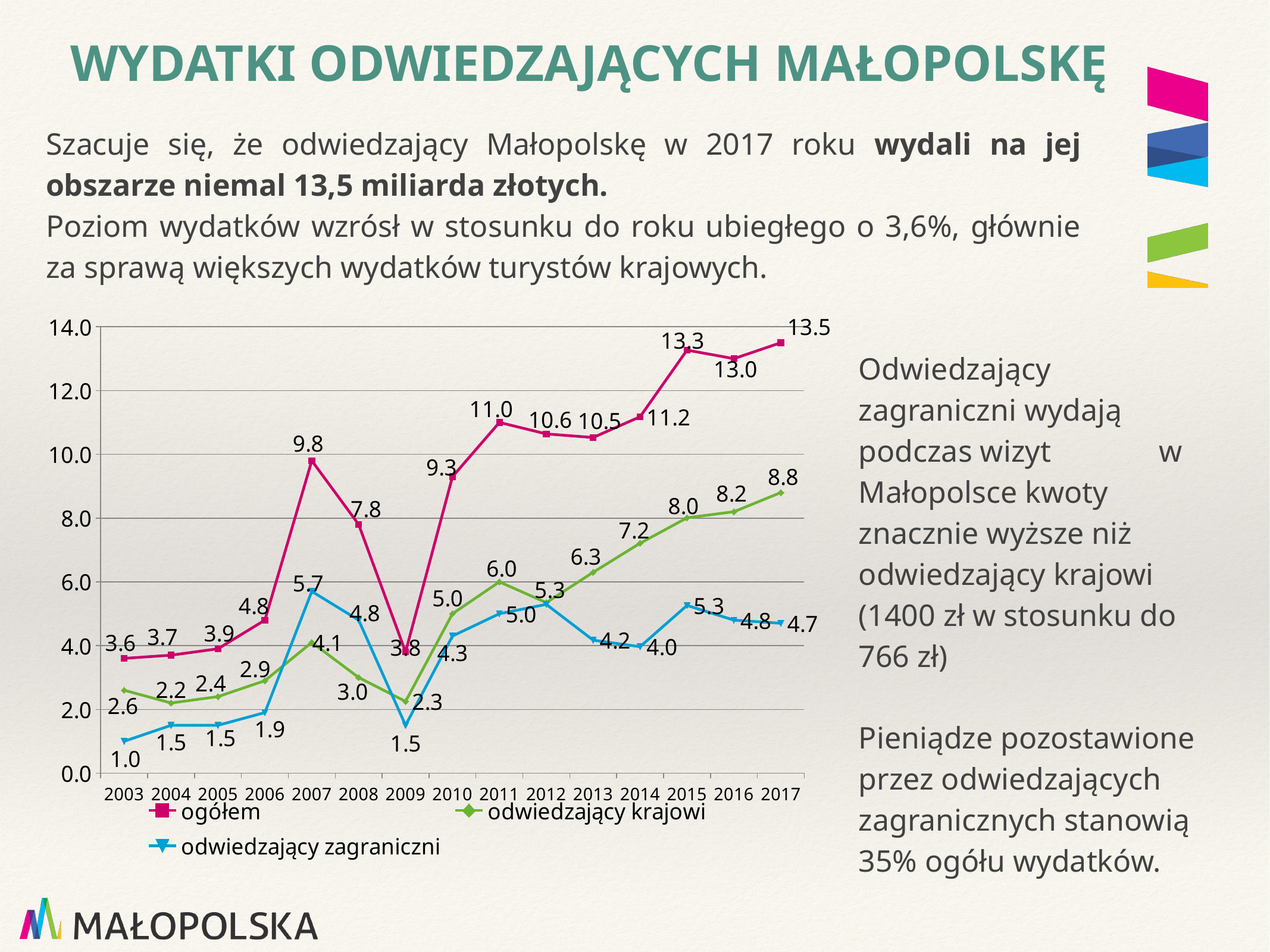
What colour is the line for the 'ogółem' series? pink In which year is the 'odwiedzający zagraniczni' series at its lowest value? 2003 Which is larger in 2012: the value for 'odwiedzający krajowi' or for 'odwiedzający zagraniczni'? Neither; both are 5.3 Does the 'odwiedzający krajowi' series rise or fall between 2013 and 2017? rise How many years are shown on the x axis? 15 What type of chart is shown on the slide? line chart What is the difference between the 'ogółem' values in 2007 and 2009? 6.0 In which year does the 'ogółem' series reach its highest value? 2017 What is the value of the 'ogółem' series in 2017? 13.5 What is the value of the 'odwiedzający krajowi' series in 2014? 7.2 What is the value of the 'odwiedzający zagraniczni' series in 2007? 5.7 How many series does the legend list? 3